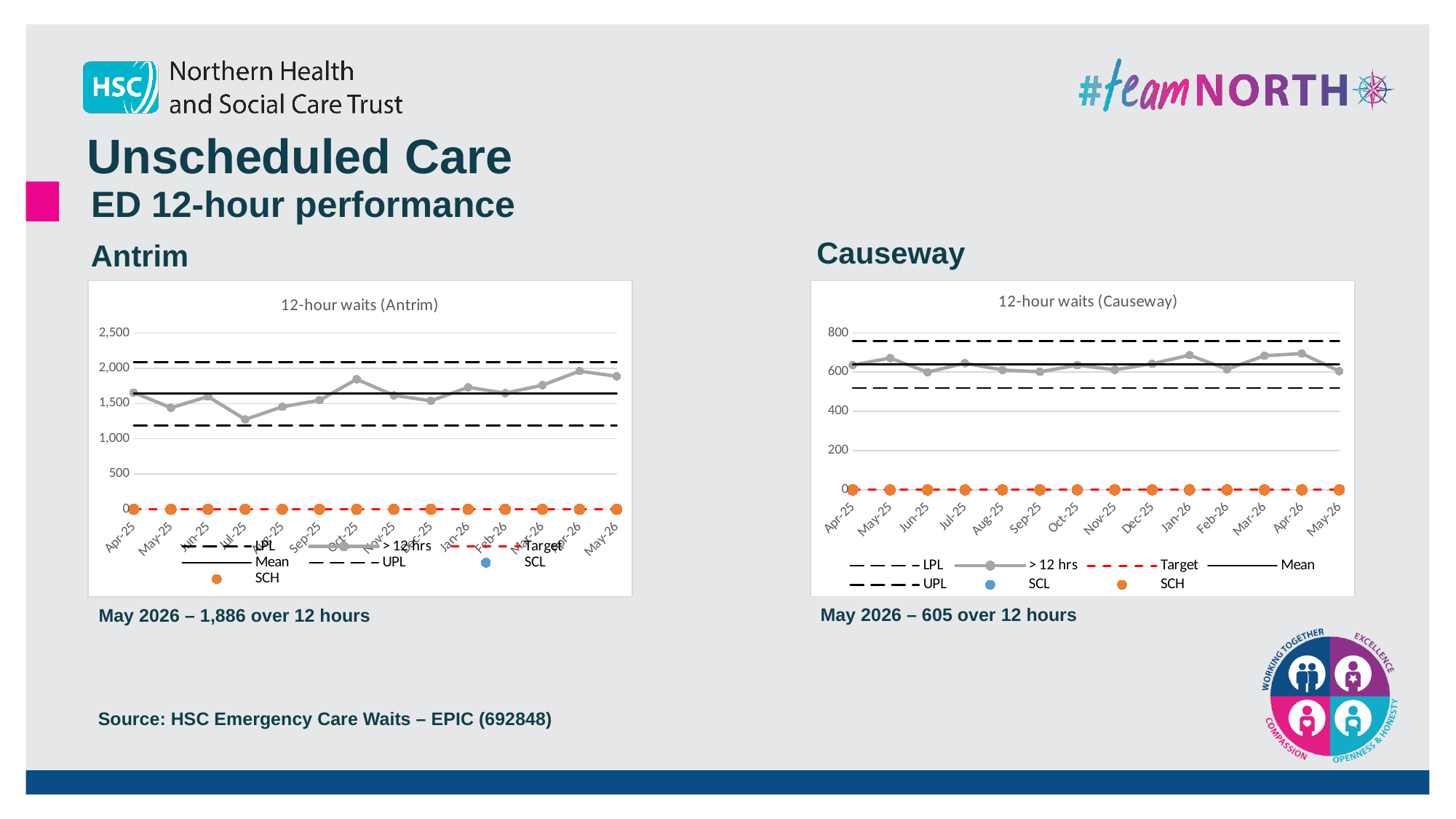
According to the Antrim chart caption, how many patients waited over 12 hours in May 2026? 1,886 What type of chart is the 12-hour waits (Antrim) chart? line chart According to the Causeway chart caption, how many patients waited over 12 hours in May 2026? 605 In the 12-hour waits (Antrim) chart, which month has the highest > 12 hrs value? Apr-26 In the 12-hour waits (Antrim) chart, which month has the lowest > 12 hrs value? Jul-25 In the 12-hour waits (Antrim) chart, how many months are plotted along the x axis? 14 In the 12-hour waits (Causeway) chart, how many months are plotted along the x axis? 14 In the 12-hour waits (Antrim) chart, is the > 12 hrs value for Jul-25 greater or less than 1,500? less How many entries does the legend of the 12-hour waits (Antrim) chart list? 7 In the 12-hour waits (Antrim) chart, is the > 12 hrs value for Oct-25 greater or less than 1,500? greater In the 12-hour waits (Causeway) chart, is the > 12 hrs value for Jan-26 greater or less than 600? greater What type of chart is the 12-hour waits (Causeway) chart? line chart